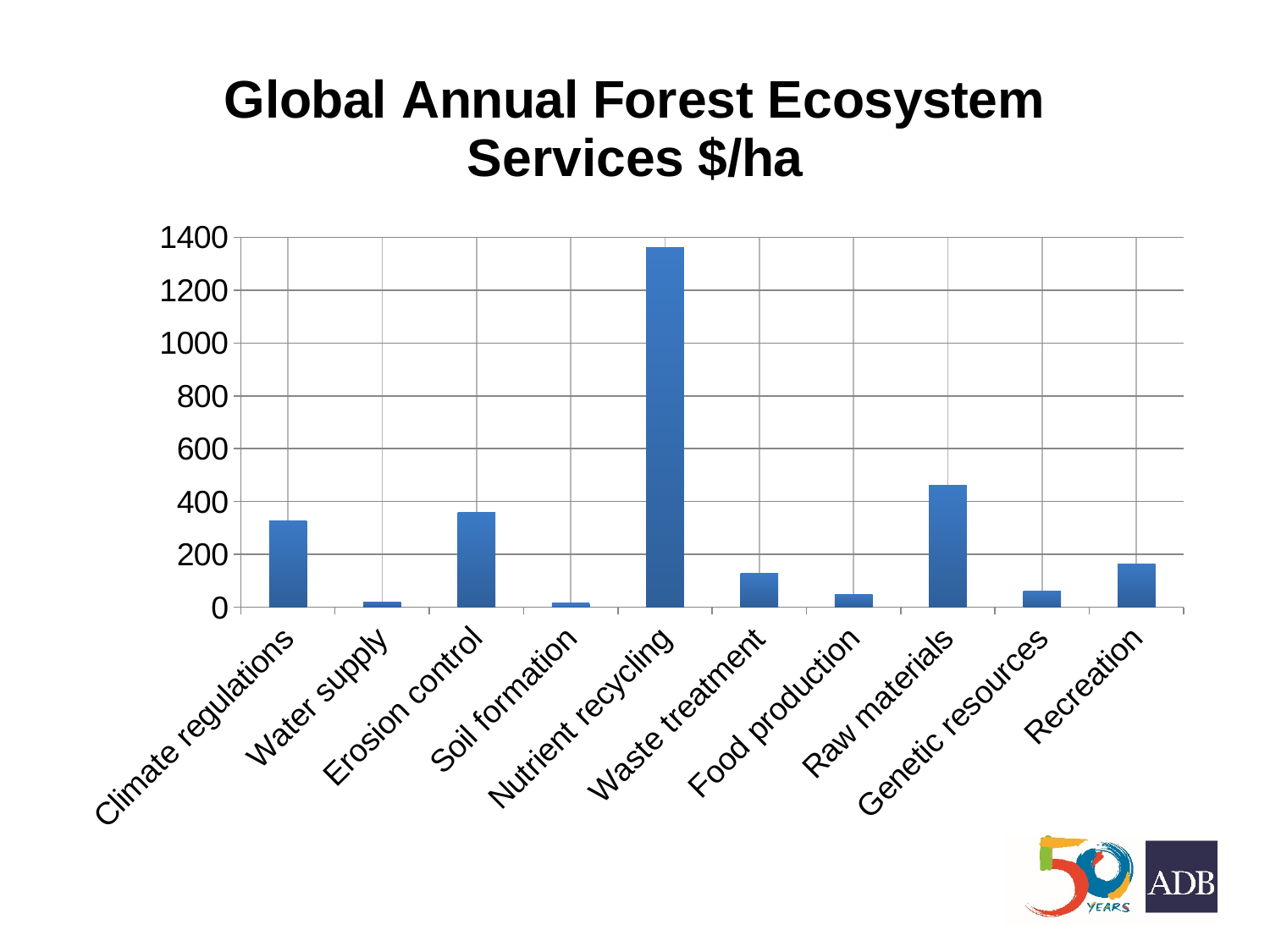
Is the value for Raw materials greater or less than 400? greater Is the value for Nutrient recycling greater or less than 1200? greater Is the value for Waste treatment greater or less than 200? less Which is larger, the value for Raw materials or the value for Erosion control? Raw materials Which category has the highest value in the chart? Nutrient recycling Which is larger, the value for Recreation or the value for Genetic resources? Recreation What kind of chart is shown on the slide? bar chart How many categories are shown on the x axis of the chart? 10 What is the title of the chart? Global Annual Forest Ecosystem Services $/ha